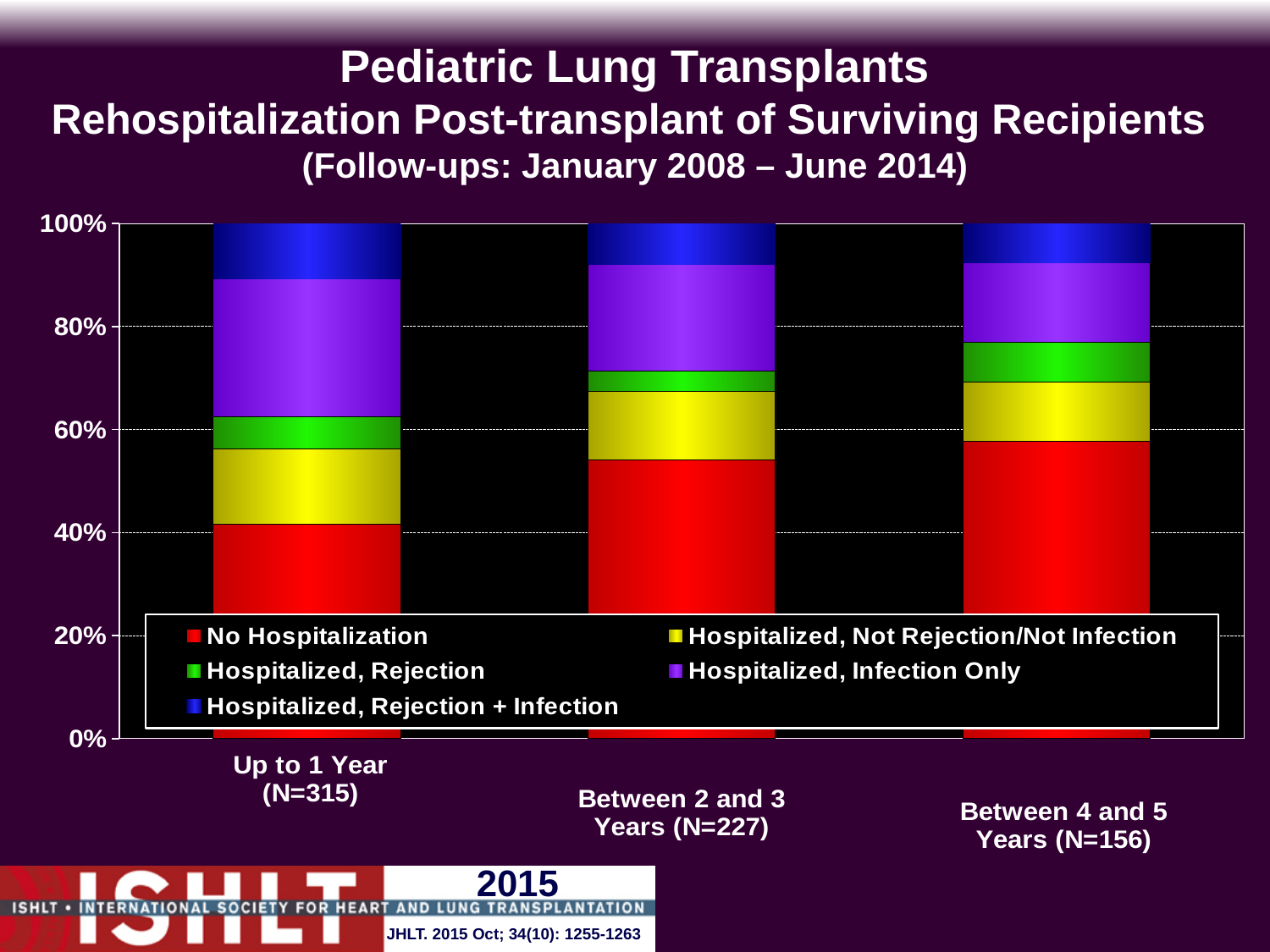
What kind of chart is shown on the slide? Stacked bar chart Is the No Hospitalization share larger for Up to 1 Year or for Between 4 and 5 Years? Between 4 and 5 Years Is the No Hospitalization share for Between 4 and 5 Years greater or less than 40%? greater Is the No Hospitalization share for Up to 1 Year greater or less than 60%? less Which follow-up category has the largest No Hospitalization share? Between 4 and 5 Years Is the Hospitalized, Infection Only share larger for Up to 1 Year or for Between 4 and 5 Years? Up to 1 Year How many series does the legend list? 5 Does the No Hospitalization share rise or fall from Up to 1 Year to Between 4 and 5 Years? rise Which follow-up category has the smallest No Hospitalization share? Up to 1 Year Is the No Hospitalization share for Between 2 and 3 Years greater or less than 60%? less How many follow-up categories are shown on the x axis? 3 What colour represents No Hospitalization in the chart? Red